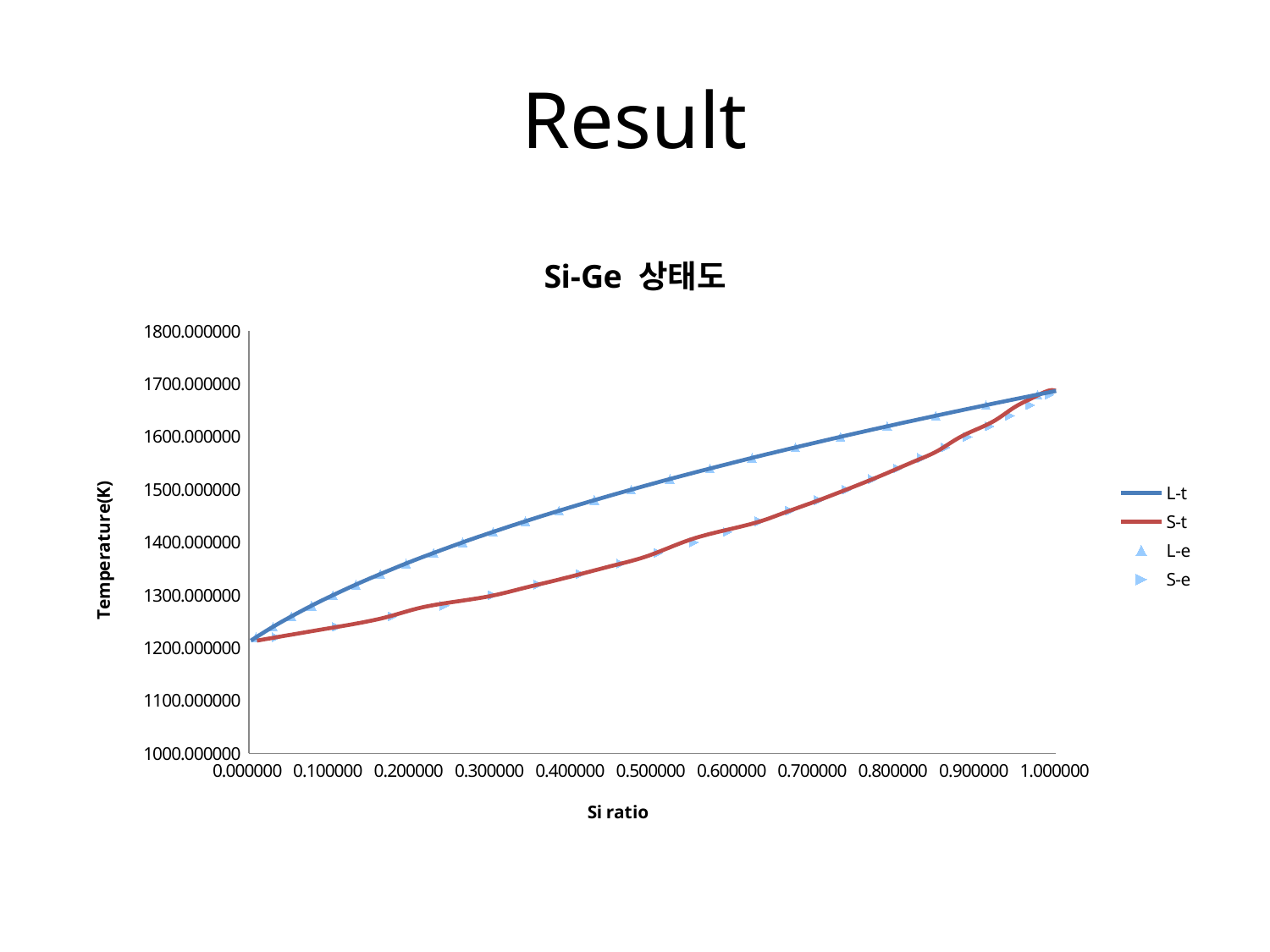
What is the title of the chart? Si-Ge 상태도 What kind of chart is shown on the slide? line chart Do the S-t values rise or fall as the Si ratio increases from 0 to 1? rise How many series does the legend list? 4 Is the S-t value at Si ratio 0.200000 greater or less than 1300? less Do the L-t values rise or fall as the Si ratio increases from 0 to 1? rise At which Si ratio does the L-t series reach its highest temperature? 1.000000 What is the label of the y axis? Temperature(K) At Si ratio 0.500000, which series has the higher temperature, L-t or S-t? L-t Is the S-t value at Si ratio 0.500000 greater or less than 1400? less Is the L-t value at Si ratio 0.500000 greater or less than 1500? greater